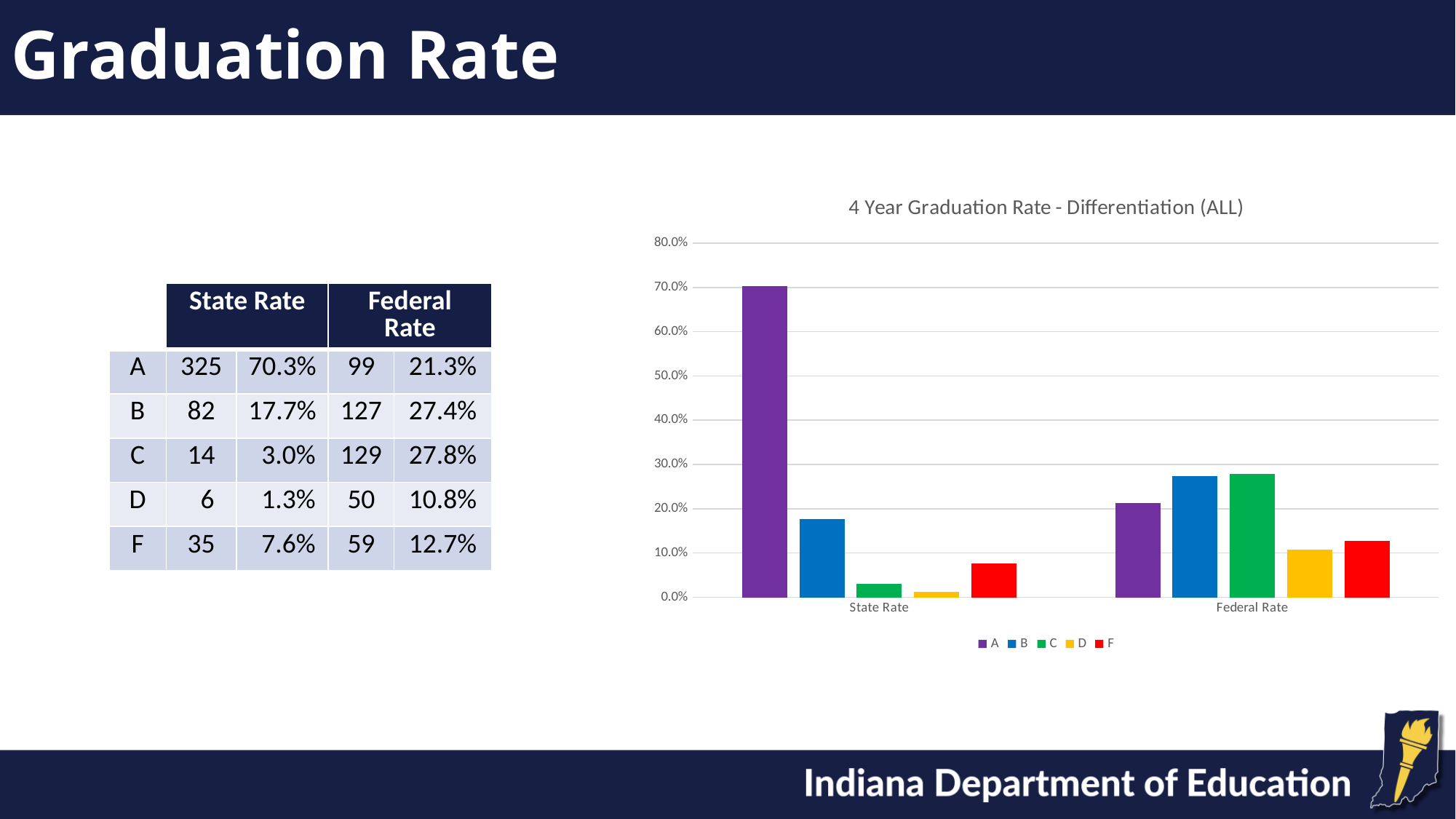
Which series has the lowest value in the State Rate category? D Which is larger: series A in the State Rate category or series A in the Federal Rate category? State Rate Which colour represents series C in the chart? green Which series has the lowest value in the Federal Rate category? D What type of chart is shown on the slide? bar chart How many categories are shown on the x axis of the chart? 2 Is the value for series F in the Federal Rate category greater or less than 20.0%? less What is the title of the chart? 4 Year Graduation Rate - Differentiation (ALL) Which series has the highest value in the Federal Rate category? C Is the value for series A in the State Rate category greater or less than 60.0%? greater How many series does the chart legend list? 5 Which series has the highest value in the State Rate category? A